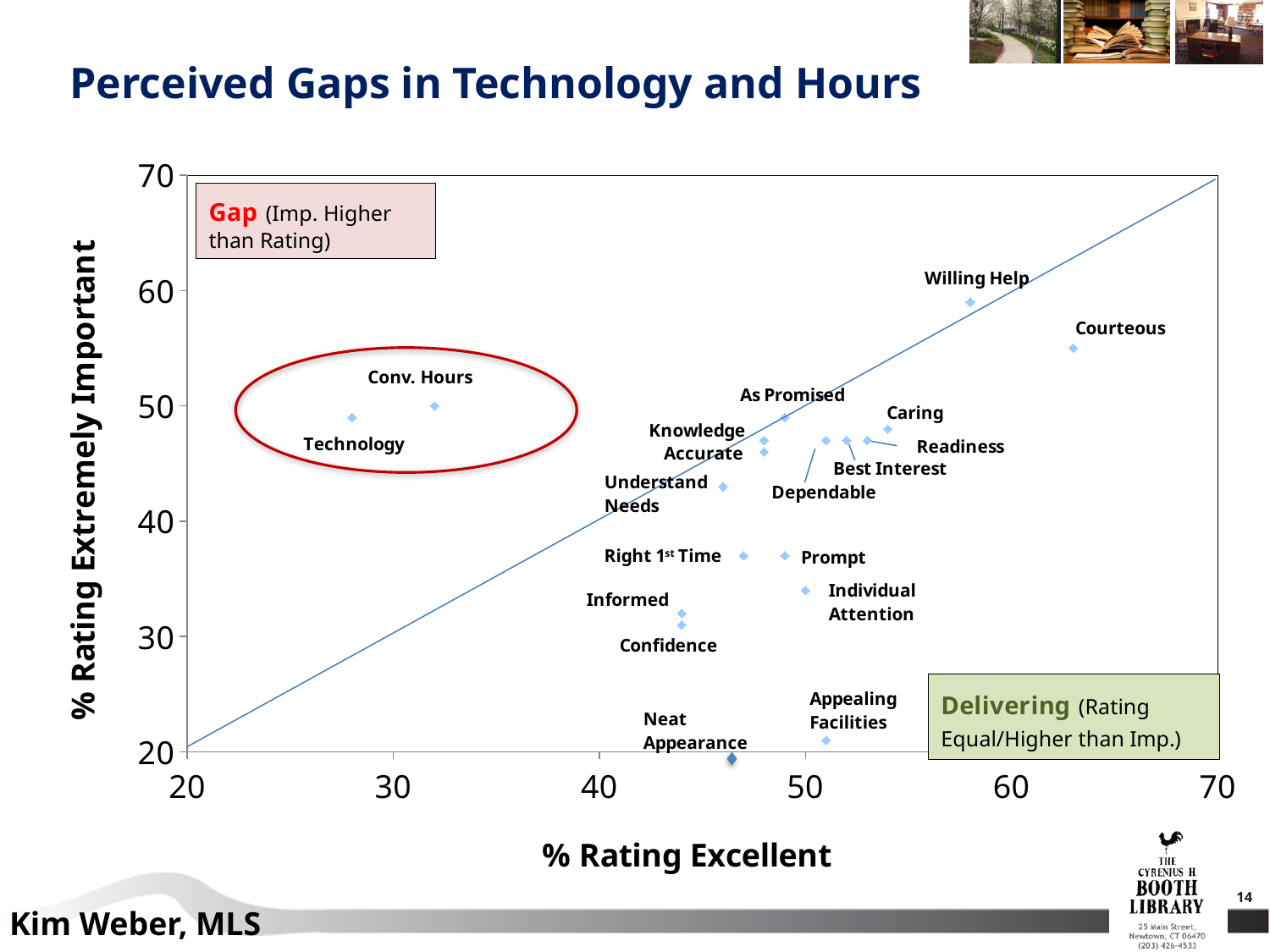
Is the % Rating Excellent for Technology greater or less than 30? less What kind of chart is shown on the slide? Scatter chart What is the title of the chart? Perceived Gaps in Technology and Hours Is the % Rating Extremely Important for Neat Appearance greater or less than 30? less Which has a higher % Rating Extremely Important, Conv. Hours or Informed? Conv. Hours Which point has the lowest % Rating Excellent? Technology Which point has the lowest % Rating Extremely Important? Neat Appearance What is the label of the x axis? % Rating Excellent Which point has the highest % Rating Extremely Important? Willing Help Which point has the highest % Rating Excellent? Courteous Is the % Rating Extremely Important for Willing Help greater or less than 50? greater Which has a higher % Rating Excellent, Courteous or Willing Help? Courteous